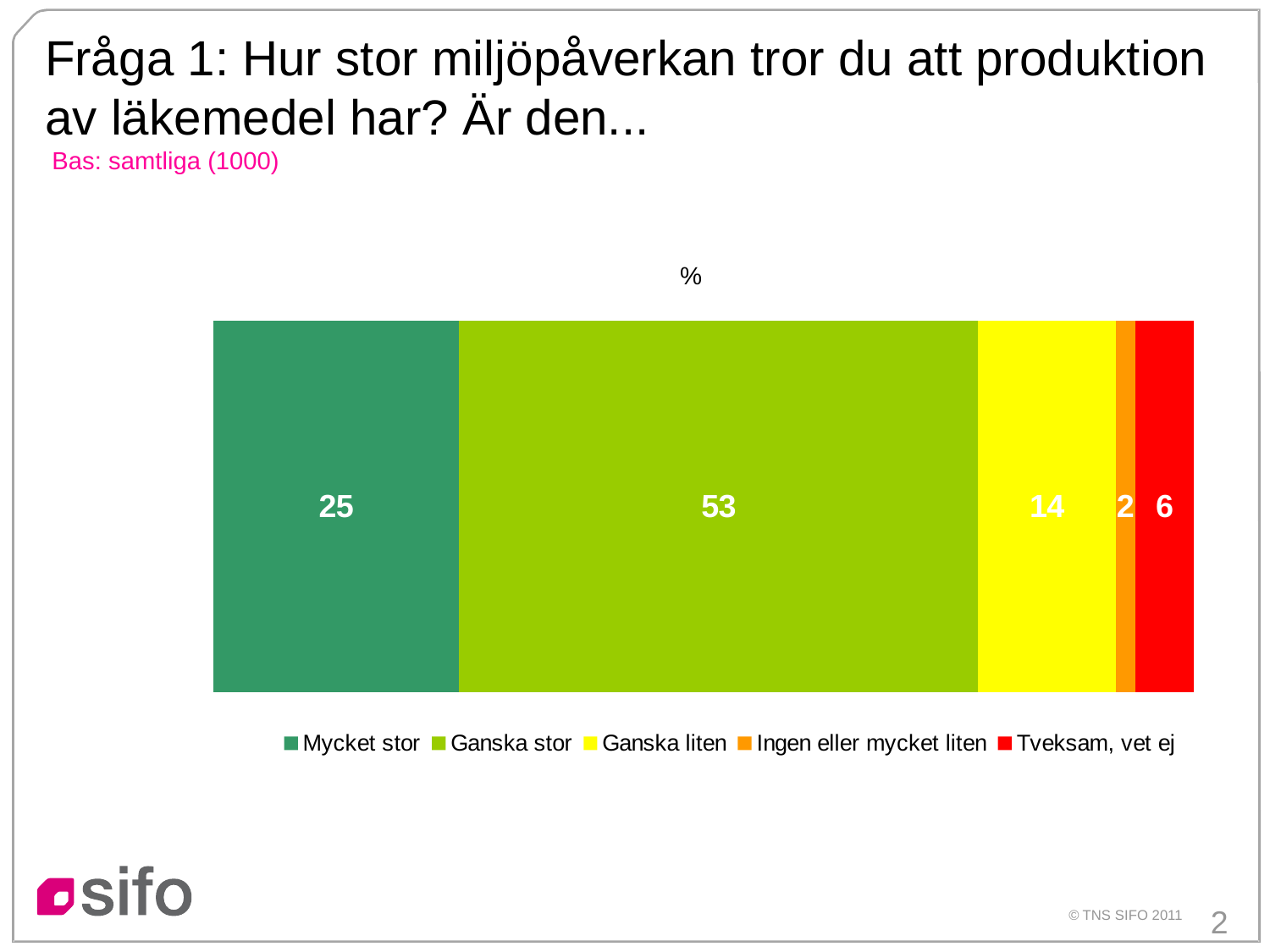
What value is shown for "Ganska stor"? 53 Which response category has the highest value? Ganska stor What value is shown for "Ganska liten"? 14 Which response category has the lowest value? Ingen eller mycket liten What kind of chart is shown on the slide? Stacked bar chart What is the difference between the values for "Ganska stor" and "Mycket stor"? 28 Which is larger, the value for "Ganska liten" or the value for "Tveksam, vet ej"? Ganska liten What value is shown for "Tveksam, vet ej"? 6 How many series does the legend list? 5 What is the total of all segments in the stacked bar? 100 What value is shown for "Ingen eller mycket liten"? 2 What percentage of respondents answered "Mycket stor"? 25